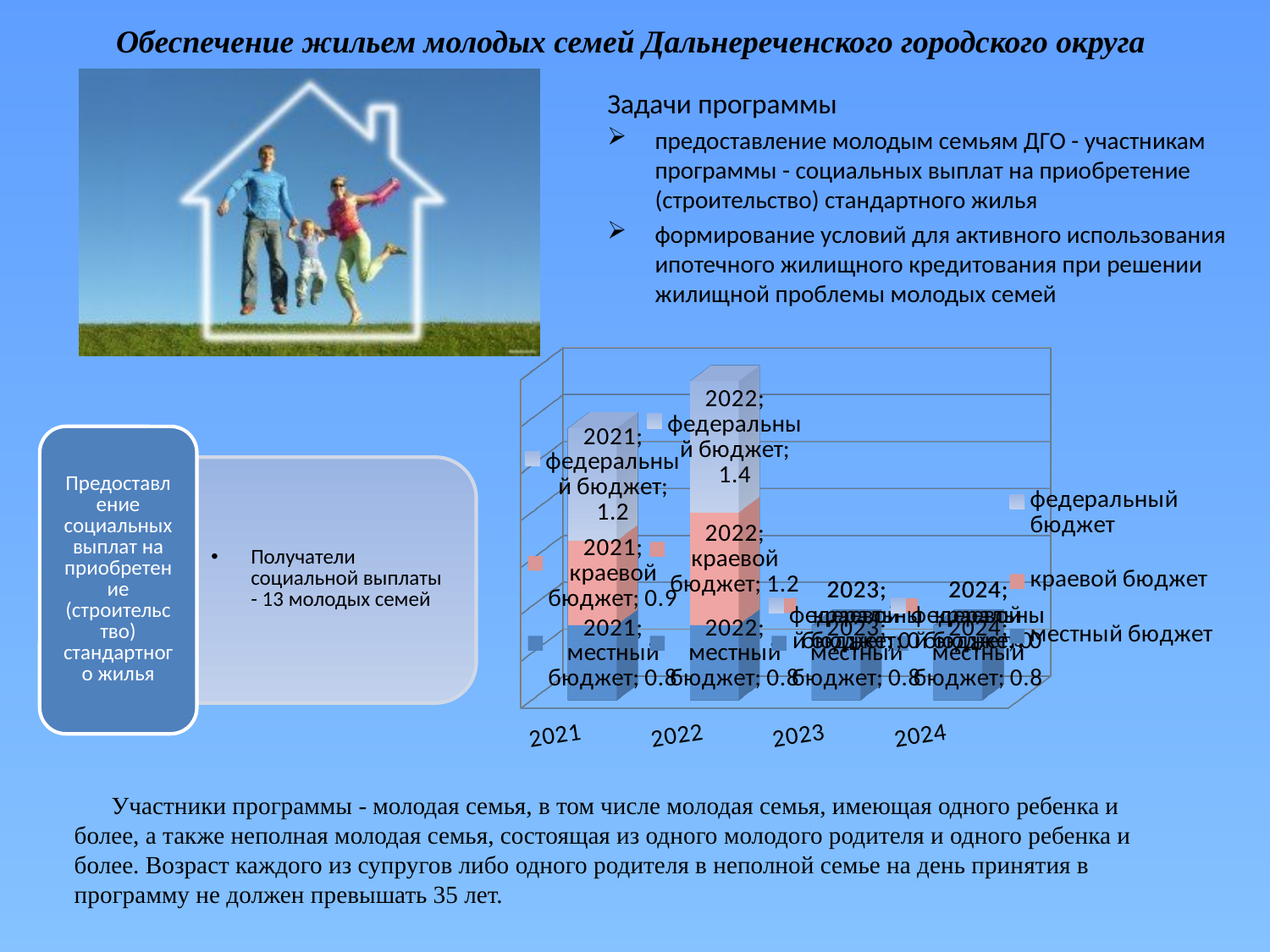
What type of chart is shown on the slide? bar chart What is the value of местный бюджет for 2023? 0.8 What is the difference between краевой бюджет in 2022 and in 2021? 0.3 How many series does the chart legend list? 3 What is the value of краевой бюджет for 2022? 1.2 What is the value of федеральный бюджет for 2021? 1.2 Which series is listed last in the chart legend? местный бюджет Which is larger: федеральный бюджет in 2021 or in 2022? 2022 What is the total of the stacked bar for 2021? 2.9 What is the value of федеральный бюджет for 2022? 1.4 Which year has the tallest stacked bar? 2022 How many years are shown on the x axis of the chart? 4